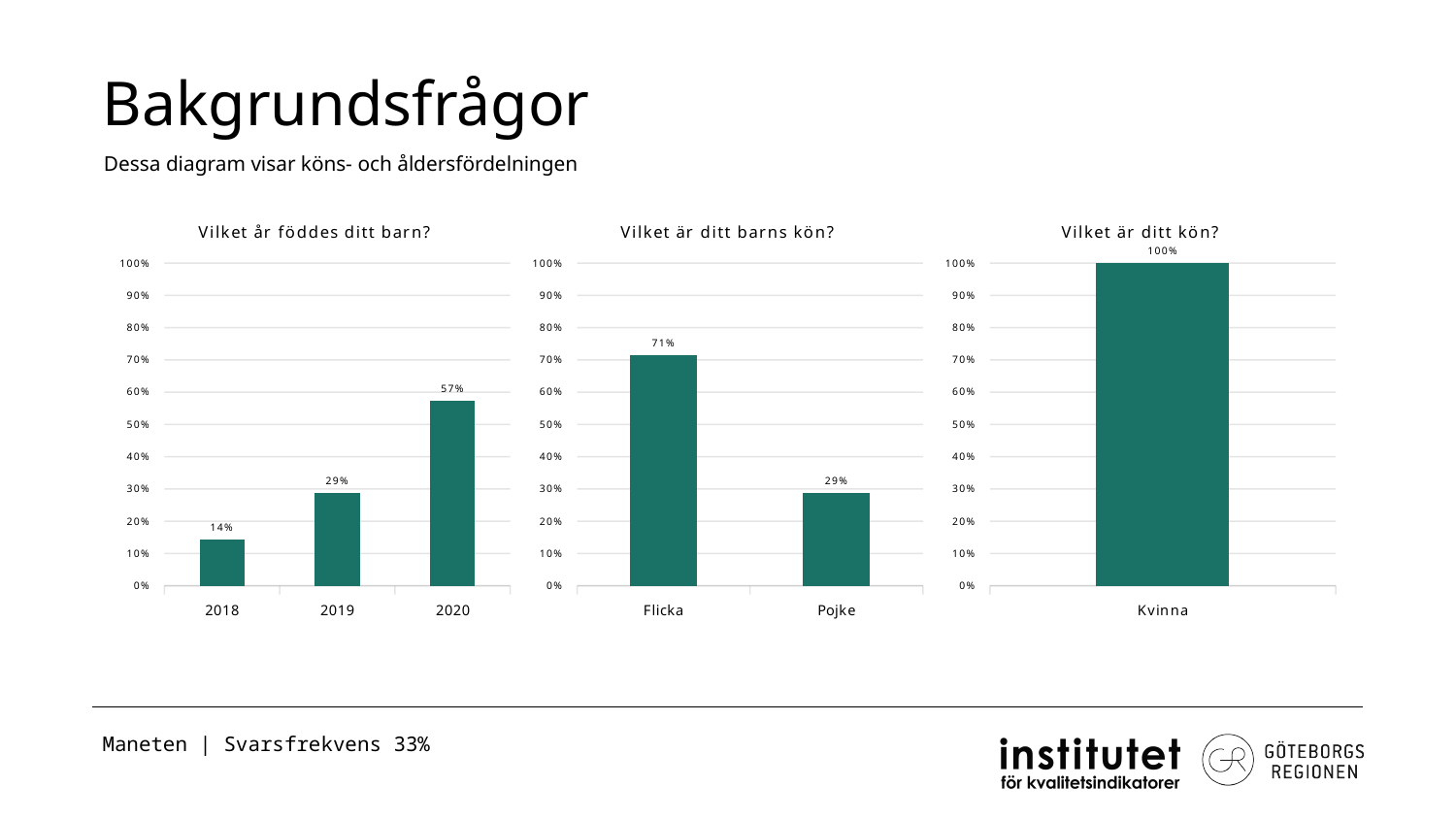
In the chart 'Vilket år föddes ditt barn?', how many years are shown? 3 In the chart 'Vilket år föddes ditt barn?', which year has the highest value? 2020 In the chart 'Vilket är ditt barns kön?', what is the value for Pojke? 29% In the chart 'Vilket är ditt barns kön?', what is the value for Flicka? 71% In the chart 'Vilket år föddes ditt barn?', which year has the lowest value? 2018 In the chart 'Vilket är ditt barns kön?', which category is larger, Flicka or Pojke? Flicka In the chart 'Vilket är ditt kön?', what is the value for Kvinna? 100% In the chart 'Vilket år föddes ditt barn?', what is the difference between the values for 2020 and 2018? 43% In the chart 'Vilket år föddes ditt barn?', do the values rise or fall from 2018 to 2020? rise In the chart 'Vilket är ditt barns kön?', what is the difference between Flicka and Pojke? 42% What kind of chart is 'Vilket är ditt kön?'? bar chart In the chart 'Vilket år föddes ditt barn?', what is the value for 2019? 29%